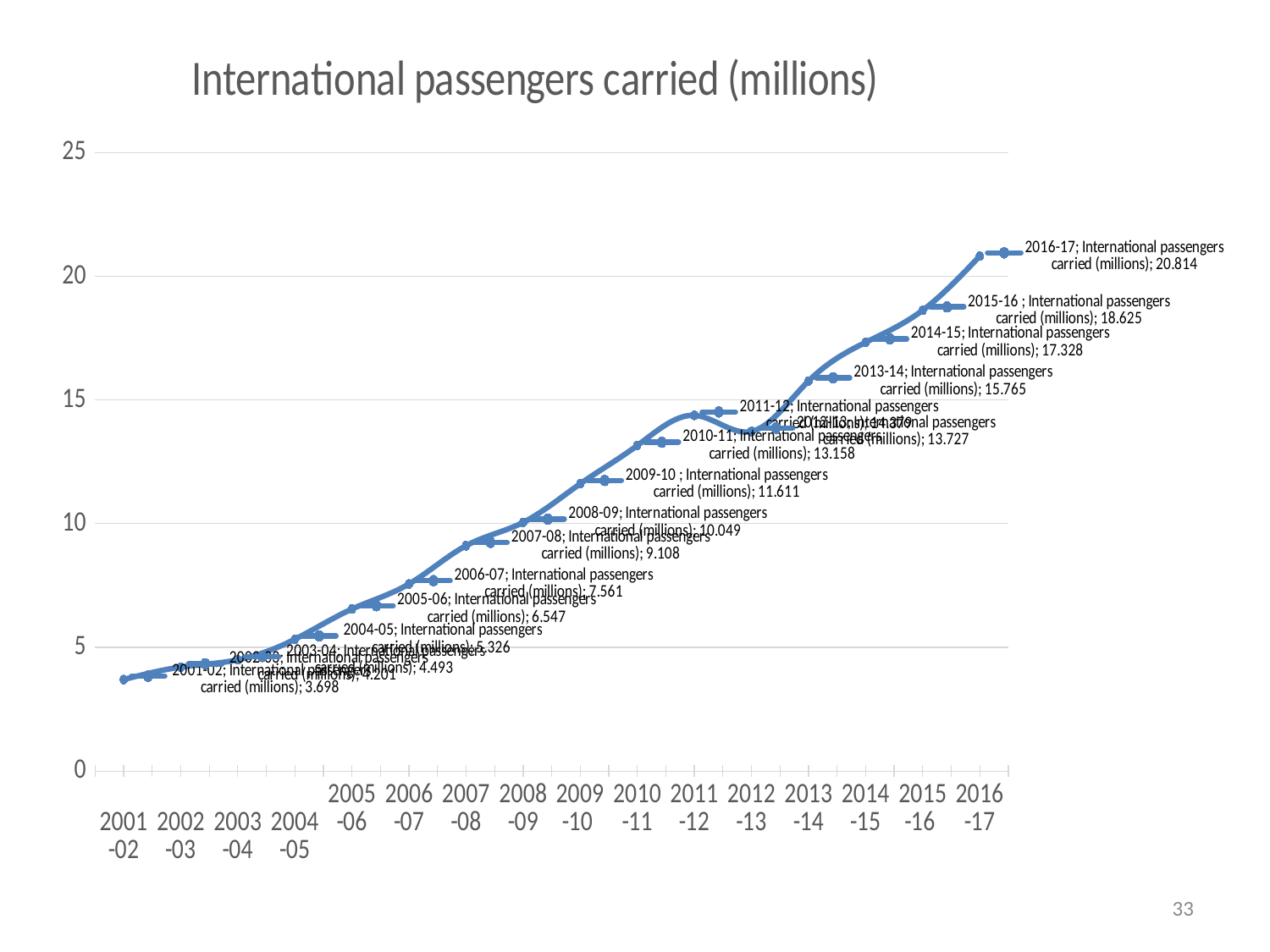
What is the value for 2009-10? 11.611 What is the difference between the values for 2008-09 and 2007-08? 0.941 What is the difference between the values for 2016-17 and 2015-16? 2.189 What is the value for 2005-06? 6.547 What is the value for 2016-17? 20.814 Which is larger, the value for 2012-13 or the value for 2013-14? 2013-14 Do the values generally rise or fall from 2001-02 to 2016-17? rise Is the value for 2011-12 greater or less than 15? less Which year has the highest number of international passengers carried? 2016-17 Which year has the lowest number of international passengers carried? 2001-02 How many data points are plotted on the chart? 16 What kind of chart is shown on the slide? line chart